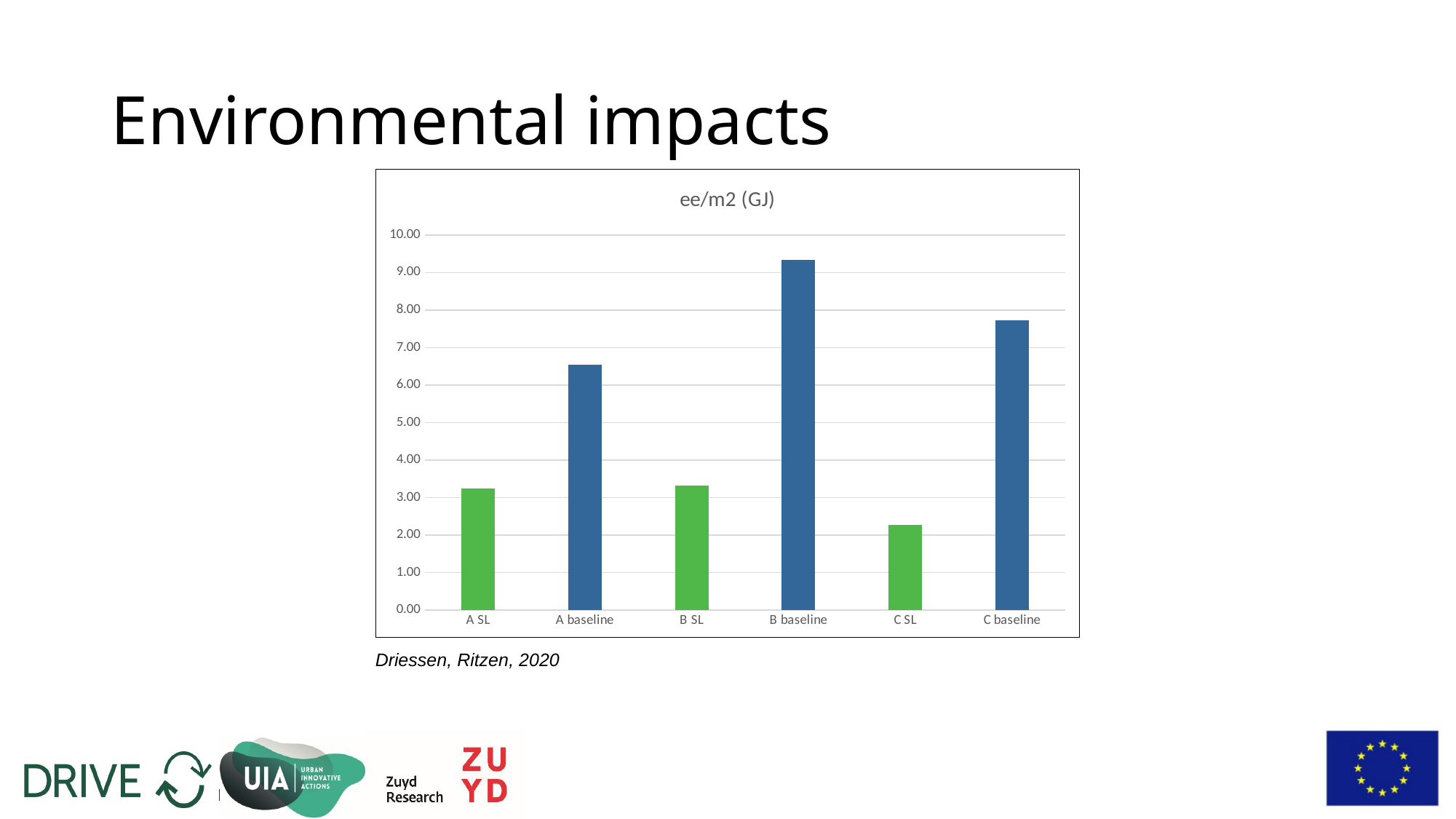
Which is larger, the value for A baseline or the value for C baseline? C baseline Is the value for B baseline greater or less than 9.00? greater Is the value for C baseline greater or less than 8.00? less What colour are the bars for the baseline categories? blue Which is larger, the value for B SL or the value for C SL? B SL Is the value for A baseline greater or less than 7.00? less Which category has the highest value in the chart? B baseline What is the title of the chart? ee/m2 (GJ) What kind of chart is shown on the slide? bar chart How many categories are plotted on the x axis of the chart? 6 Which category has the lowest value in the chart? C SL